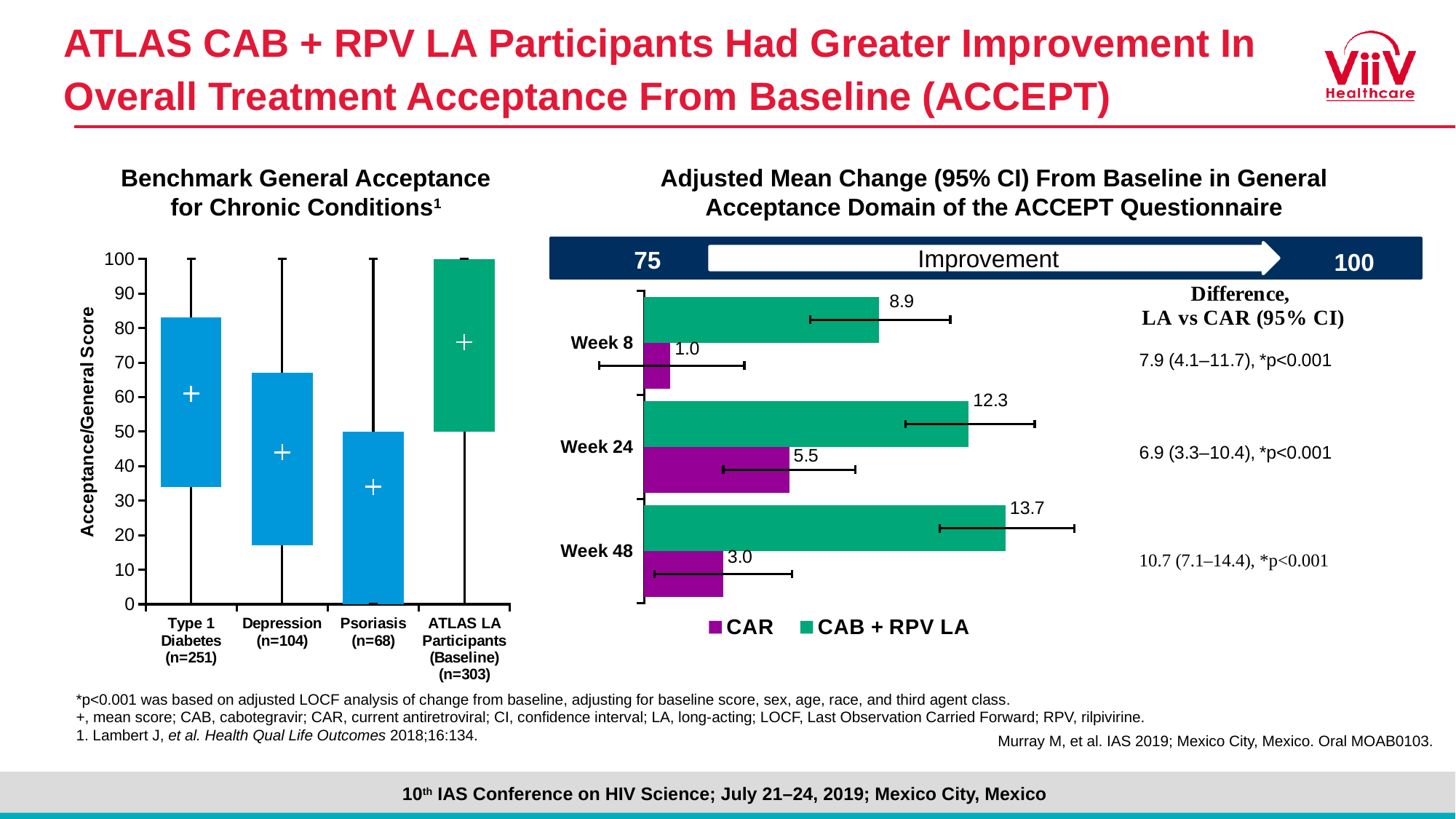
In the 'Benchmark General Acceptance for Chronic Conditions' chart on the left, is the mean score (+) for ATLAS LA Participants (Baseline) greater or less than 70? greater In the 'Adjusted Mean Change' chart on the right, at which week is the CAR value lowest? Week 8 In the 'Adjusted Mean Change' chart on the right, how many series does the legend list? 2 In the 'Benchmark General Acceptance for Chronic Conditions' chart on the left, is the mean score (+) for Psoriasis greater or less than 40? less In the 'Benchmark General Acceptance for Chronic Conditions' chart on the left, how many categories are shown on the x axis? 4 In the 'Adjusted Mean Change' chart on the right, what is the value for CAR at Week 24? 5.5 In the 'Adjusted Mean Change' chart on the right, which is larger at Week 48: CAB + RPV LA or CAR? CAB + RPV LA In the 'Adjusted Mean Change' chart on the right, what is the difference between the CAB + RPV LA and CAR values at Week 24? 6.8 In the 'Adjusted Mean Change' chart on the right, at which week is the CAB + RPV LA value highest? Week 48 In the 'Adjusted Mean Change' chart on the right, what is the value for CAR at Week 48? 3.0 In the 'Adjusted Mean Change' chart on the right, what is the value for CAB + RPV LA at Week 8? 8.9 In the 'Adjusted Mean Change' chart on the right, do the CAB + RPV LA values rise or fall from Week 8 to Week 48? rise